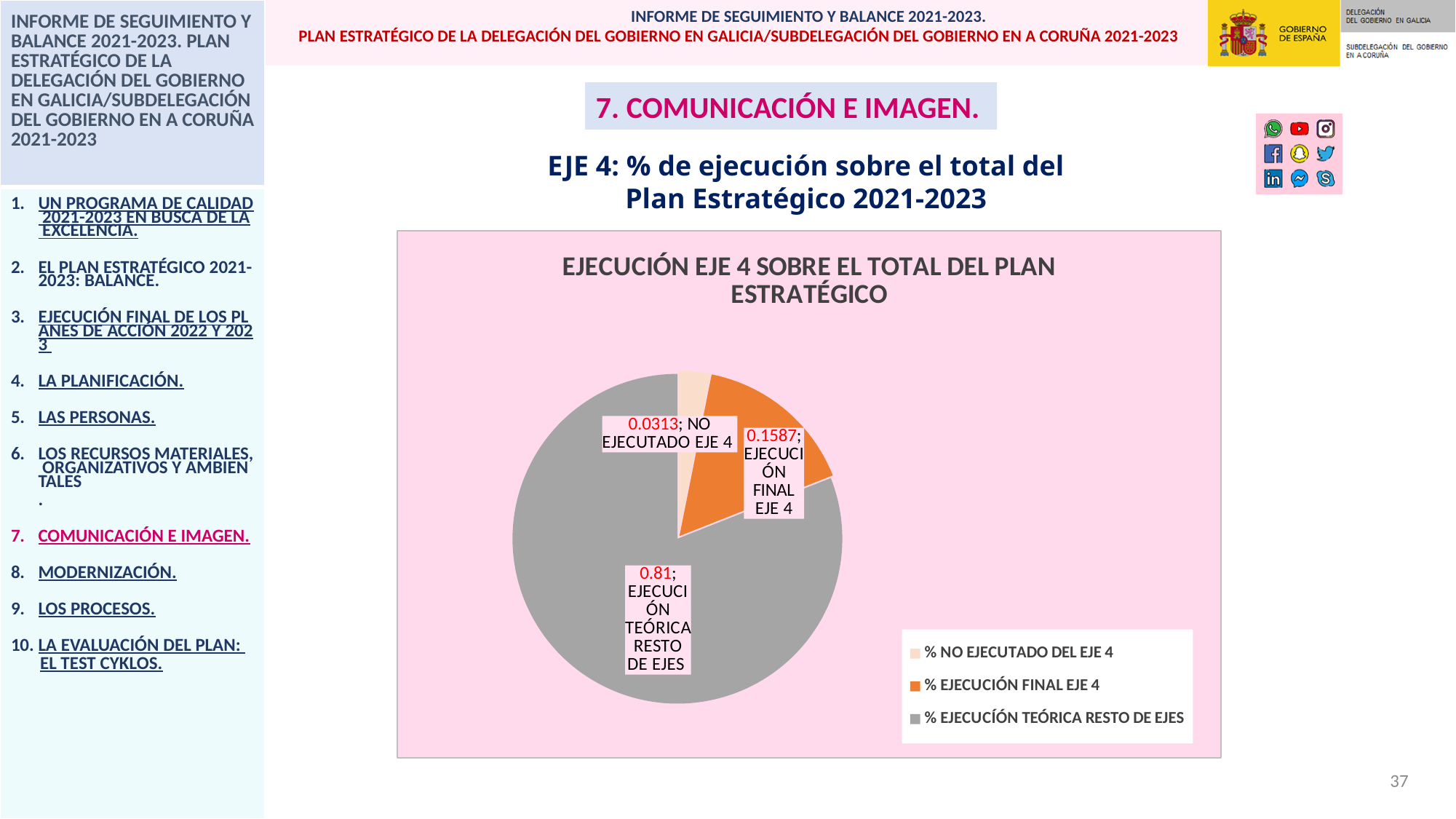
What colour is the EJECUCIÓN FINAL EJE 4 slice? Orange How many entries does the legend list? 3 What is the title of the chart? EJECUCIÓN EJE 4 SOBRE EL TOTAL DEL PLAN ESTRATÉGICO What type of chart is shown on the slide? Pie chart What is the value shown for the NO EJECUTADO EJE 4 slice? 0.0313 Which slice of the pie has the smallest value? NO EJECUTADO EJE 4 Which slice of the pie has the largest value? EJECUCIÓN TEÓRICA RESTO DE EJES What is the value shown for the EJECUCIÓN FINAL EJE 4 slice? 0.1587 Which is larger, the EJECUCIÓN FINAL EJE 4 slice or the NO EJECUTADO EJE 4 slice? EJECUCIÓN FINAL EJE 4 What is the value shown for the EJECUCIÓN TEÓRICA RESTO DE EJES slice? 0.81 What is the difference between the EJECUCIÓN FINAL EJE 4 value and the NO EJECUTADO EJE 4 value? 0.1274 How many slices does the pie chart have? 3